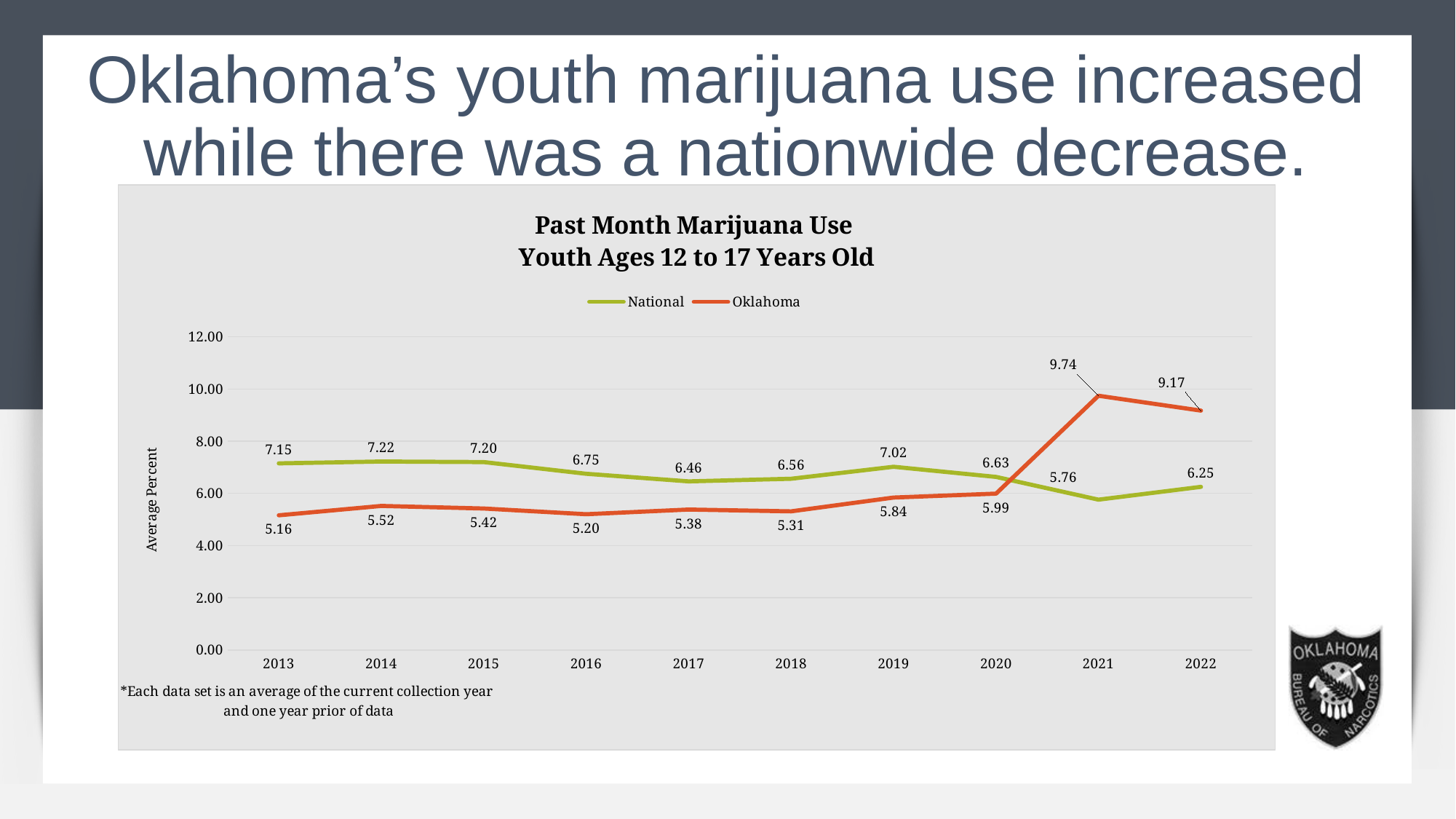
What is the label on the y axis? Average Percent In which year is the National series lowest? 2021 What is the difference between the Oklahoma and National values in 2022? 2.92 What is the National value for 2014? 7.22 How many series does the legend list? 2 How many years are shown on the x axis? 10 Is the Oklahoma value for 2021 greater or less than 8.00? greater What is the Oklahoma value for 2021? 9.74 Which series has the larger value in 2019, National or Oklahoma? National What is the Oklahoma value for 2013? 5.16 What kind of chart is shown? line chart In which year is the Oklahoma series highest? 2021